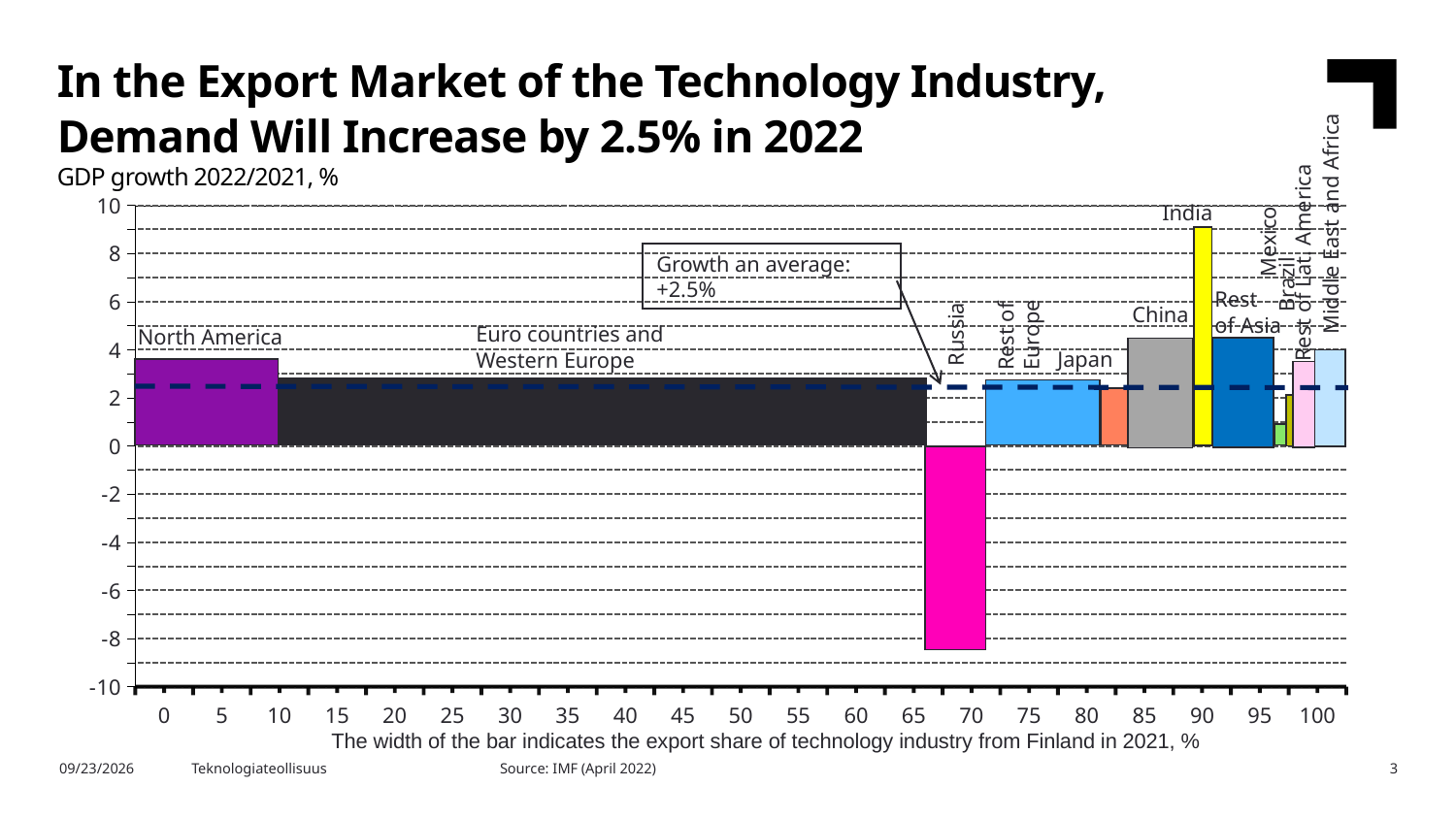
Is the GDP growth value for India greater or less than 8? greater Which region has the highest GDP growth in the chart? India Which has higher GDP growth, India or China? India According to the note below the x axis, what does the width of each bar indicate? The export share of technology industry from Finland in 2021, % Is the GDP growth value for North America greater or less than 2? greater Which region has the lowest GDP growth in the chart? Russia Is the GDP growth value for Mexico greater or less than 2? less What kind of chart is shown on the slide? bar chart Which has higher GDP growth, Russia or Japan? Japan How many regions (bars) are shown in the chart? 12 What average growth is indicated by the dashed line in the chart? +2.5%